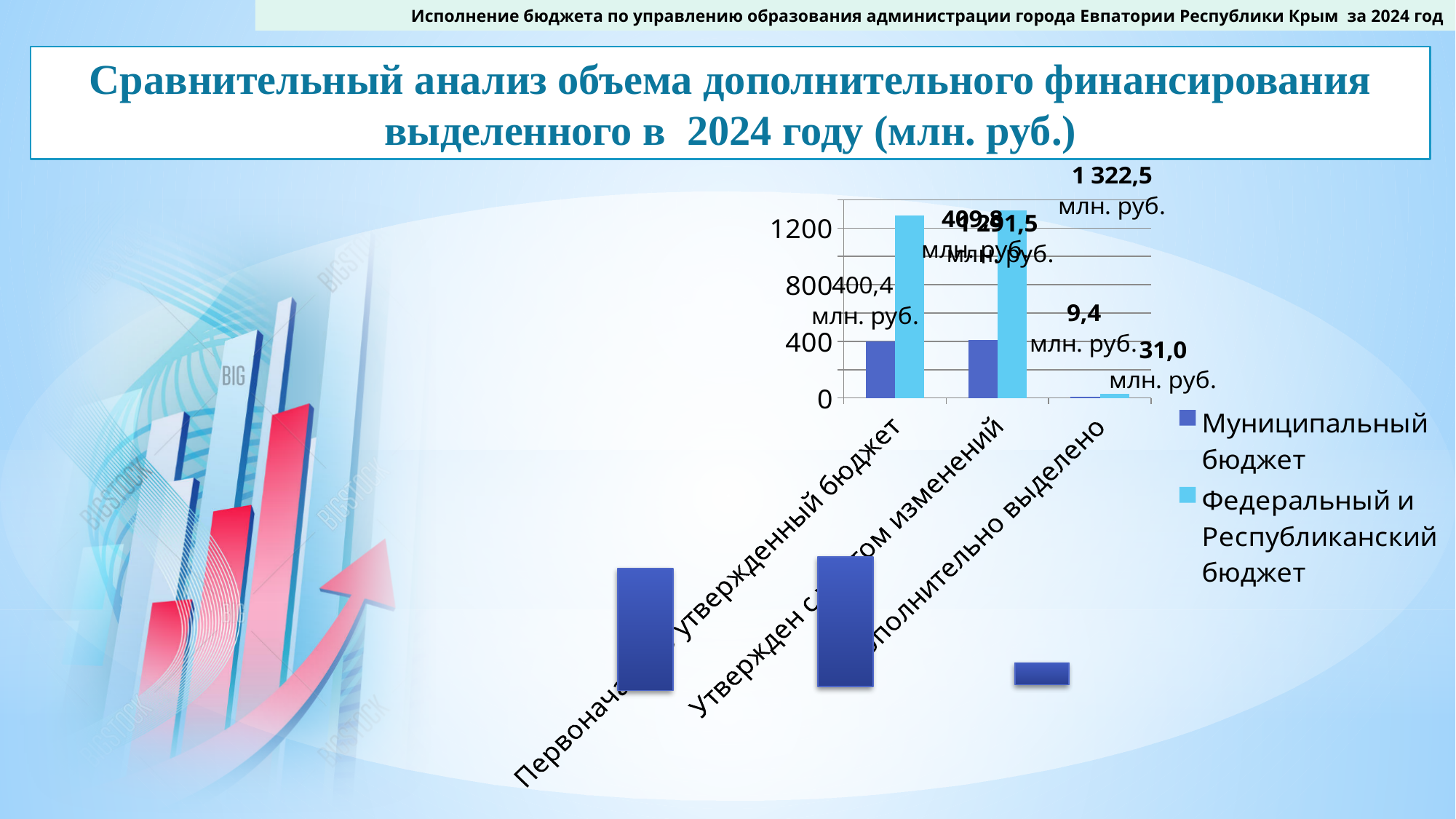
How many categories are plotted along the x axis of the chart? 3 Which category has the lowest value for Муниципальный бюджет? Дополнительно выделено What is the value of Федеральный и Республиканский бюджет for the category Дополнительно выделено? 31,0 млн. руб. What is the value of Федеральный и Республиканский бюджет for the category Утвержден с учетом изменений? 1 322,5 млн. руб. For the category Дополнительно выделено, which series has the larger value: Муниципальный бюджет or Федеральный и Республиканский бюджет? Федеральный и Республиканский бюджет What kind of chart is shown on the slide? bar chart What is the value of Муниципальный бюджет for the category Первоначально утвержденный бюджет? 400,4 млн. руб. What is the difference between the Муниципальный бюджет values for Утвержден с учетом изменений (409,8) and Первоначально утвержденный бюджет (400,4)? 9,4 млн. руб. Is the value of Федеральный и Республиканский бюджет for Первоначально утвержденный бюджет greater or less than 1200? greater Which category has the highest value for Федеральный и Республиканский бюджет? Утвержден с учетом изменений What is the value of Муниципальный бюджет for the category Дополнительно выделено? 9,4 млн. руб. How many series does the chart legend list? 2